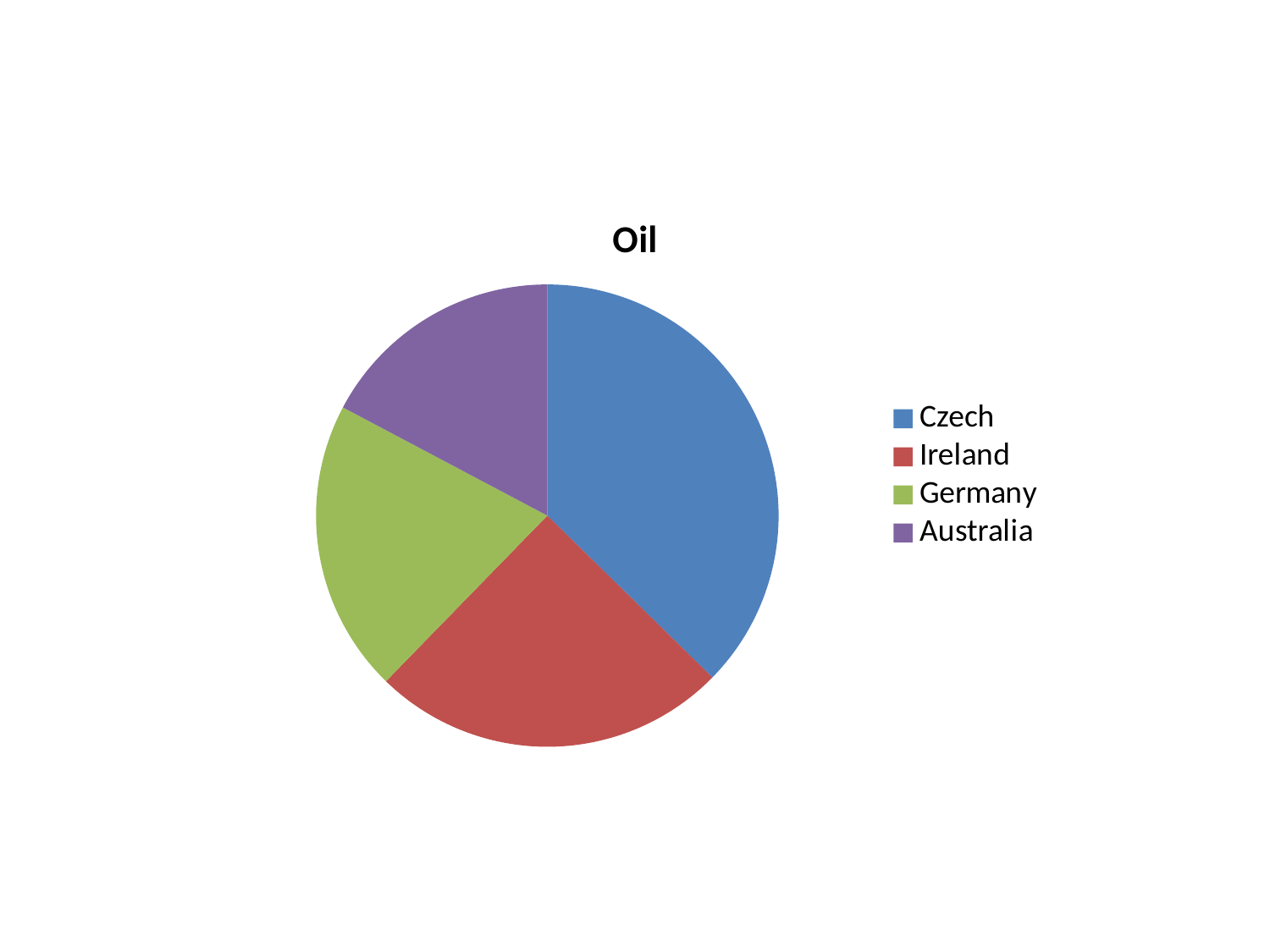
What is the title of the chart? Oil Which category is shown in green in the pie chart? Germany What kind of chart is shown on the slide? pie chart How many entries does the legend list? 4 Which category has the largest slice of the pie? Czech Which slice is larger, Ireland or Australia? Ireland Which slice is larger, Czech or Ireland? Czech Which category has the smallest slice of the pie? Australia Which slice is larger, Czech or Germany? Czech How many categories (slices) does the pie chart have? 4